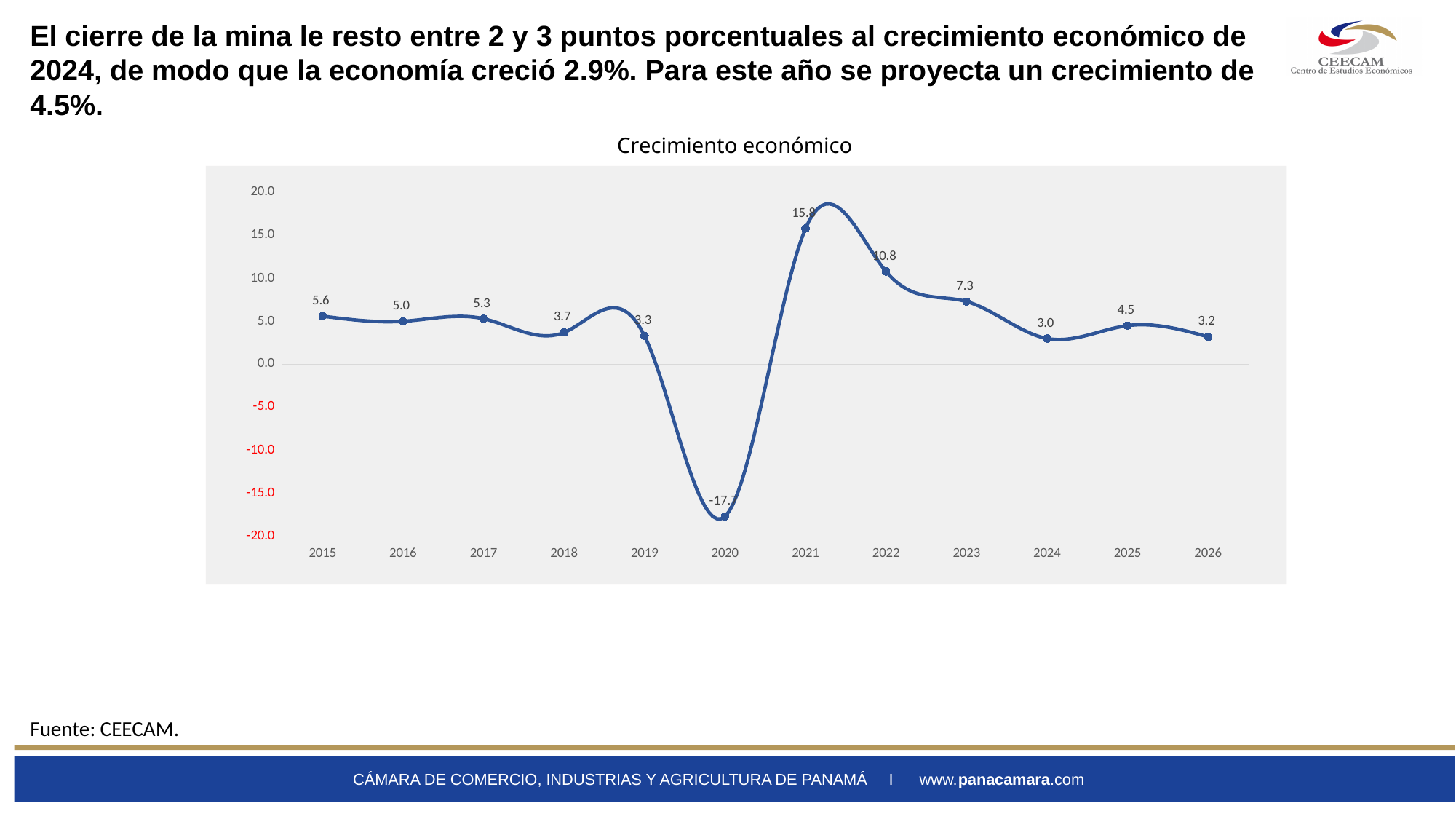
Which year has the larger value, 2025 or 2026? 2025 What is the value for 2015? 5.6 Which year has the highest value? 2021 What is the value for 2024? 3.0 What is the value for 2025? 4.5 Which year has the lowest value? 2020 What is the value for 2022? 10.8 How many years are plotted on the x axis of the chart? 12 Is the value for 2020 greater or less than -15.0? less What is the difference between the values for 2023 and 2024? 4.3 What is the title of the chart? Crecimiento económico What kind of chart is shown on the slide? line chart